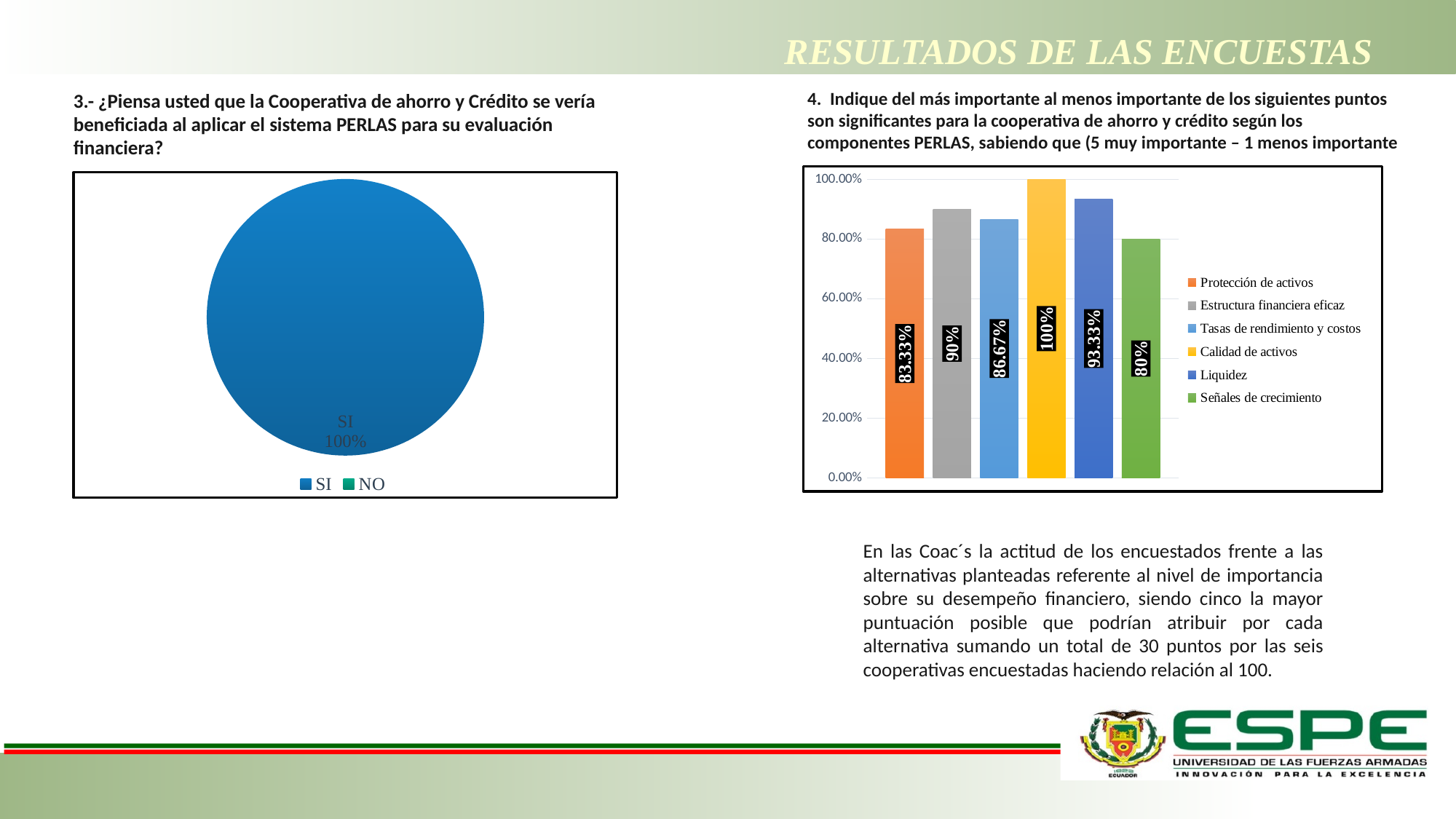
In the pie chart on the left, what share of responses is SI? 100% In the bar chart on the right, what is the value for Calidad de activos? 100% In the bar chart on the right, which is larger: Tasas de rendimiento y costos or Estructura financiera eficaz? Estructura financiera eficaz How many entries does the legend of the pie chart on the left list? 2 In the bar chart on the right, what is the value for Protección de activos? 83.33% In the bar chart on the right, what is the difference between Estructura financiera eficaz and Señales de crecimiento? 10% What kind of chart is shown on the right side of the slide? bar chart How many categories are plotted in the bar chart on the right? 6 In the bar chart on the right, what is the value for Liquidez? 93.33% What kind of chart is shown on the left side of the slide? pie chart In the bar chart on the right, which category has the lowest value? Señales de crecimiento In the bar chart on the right, which category has the highest value? Calidad de activos